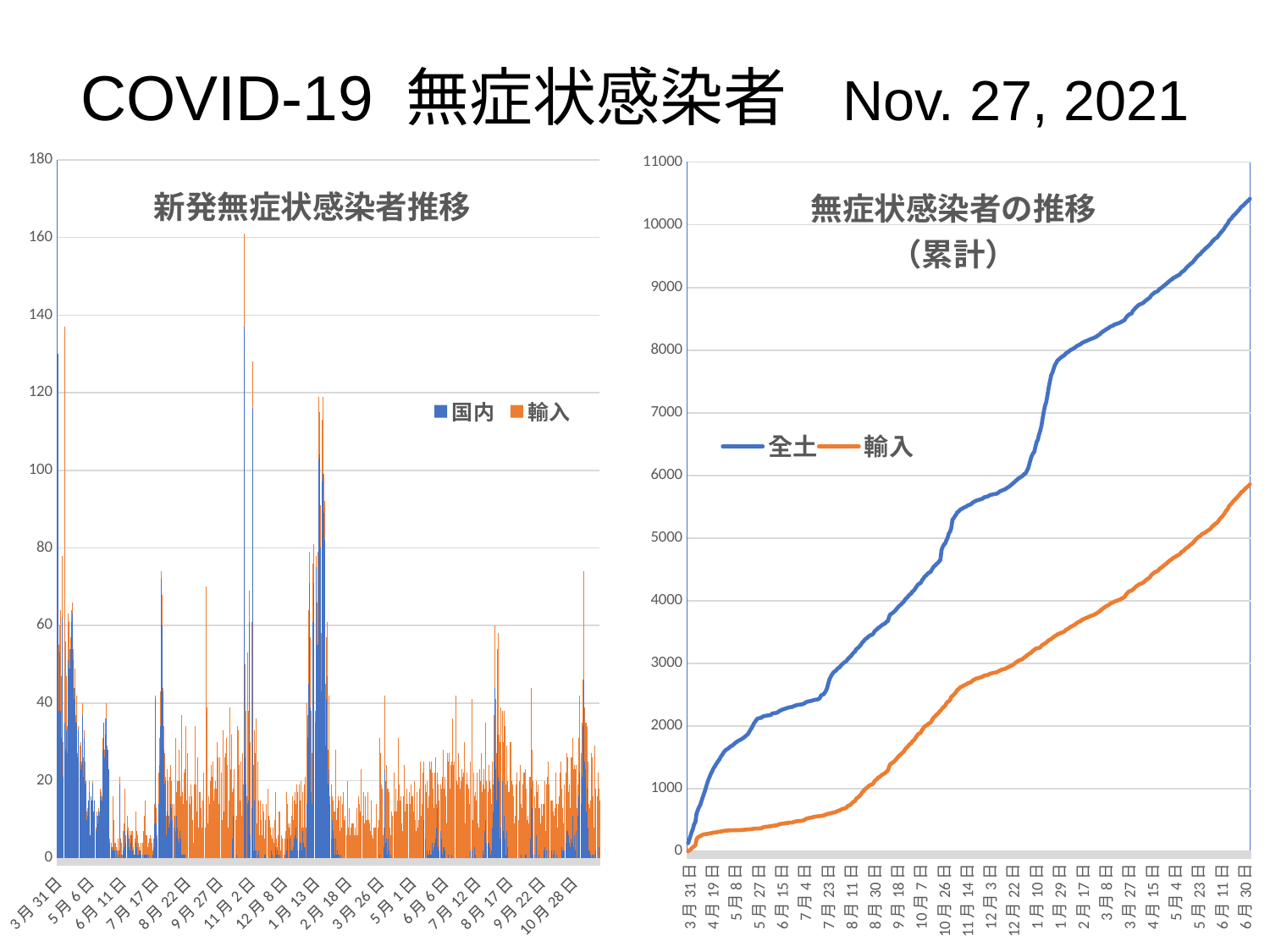
In the left chart (新発無症状感染者推移), which colour represents the 輸入 series? orange In the left chart (新発無症状感染者推移), is the tallest bar greater or less than 140? greater In the right chart (無症状感染者の推移（累計）), do the values of the 全土 line rise or fall along the x axis? rise In the right chart (無症状感染者の推移（累計）), what are the two series named in the legend? 全土 and 輸入 What kind of chart is the right chart titled 無症状感染者の推移（累計）? line chart What kind of chart is the left chart titled 新発無症状感染者推移? bar chart In the left chart (新発無症状感染者推移), which series has the tallest bar, 国内 or 輸入? 国内 How many series does the legend of the left chart (新発無症状感染者推移) list? 2 In the right chart (無症状感染者の推移（累計）), is the final value of the 全土 line greater or less than 10000? greater How many series does the legend of the right chart (無症状感染者の推移（累計）) list? 2 In the right chart (無症状感染者の推移（累計）), which series is higher at the end of the period, 全土 or 輸入? 全土 In the right chart (無症状感染者の推移（累計）), is the final value of the 輸入 line greater or less than 6000? less